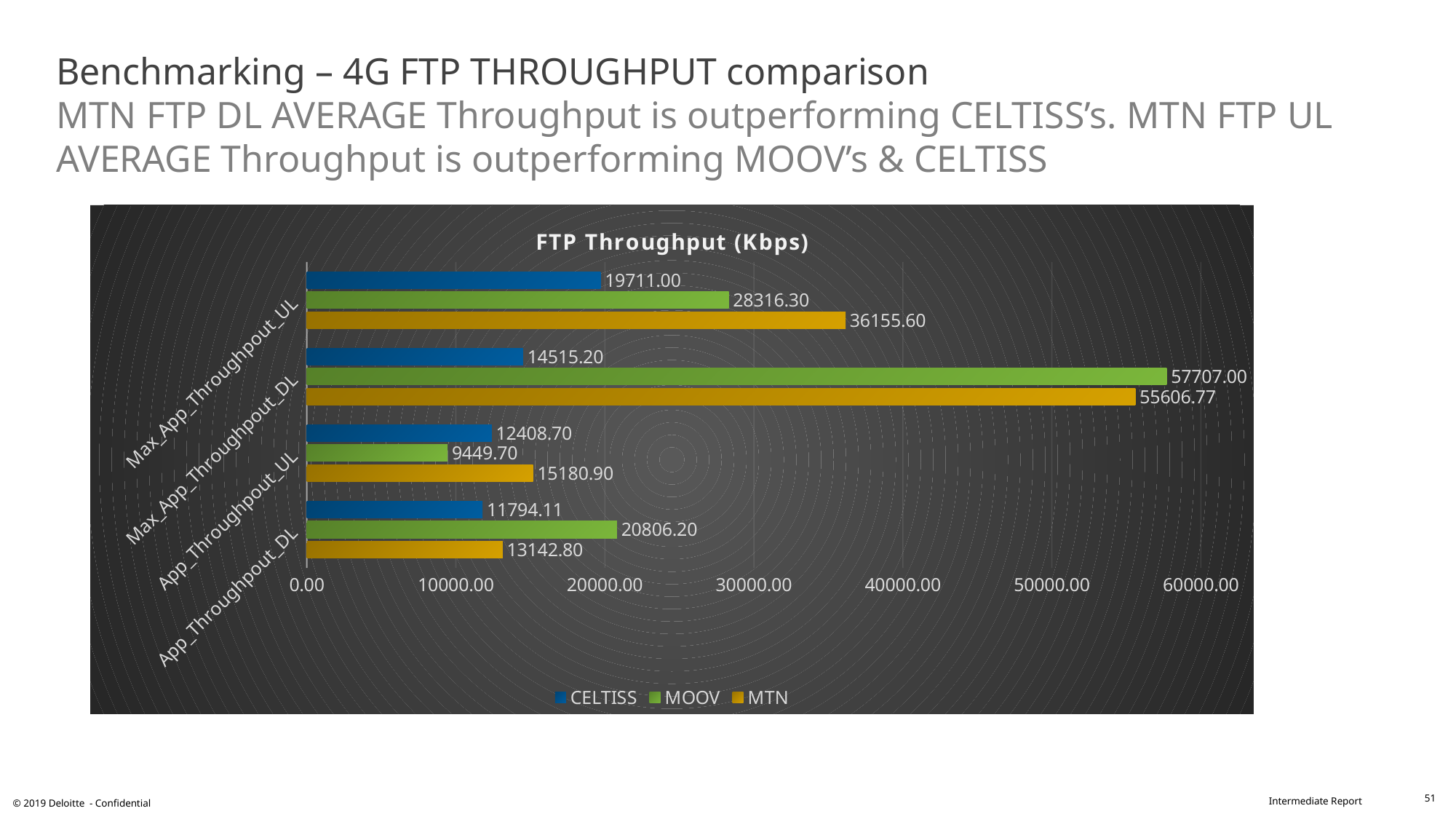
For App_Throughpout_DL, which is larger: the MTN value or the CELTISS value? MTN What is the difference between the MOOV and MTN values for Max_App_Throughpout_DL? 2100.23 How many series does the legend list? 3 What is the difference between the MTN and CELTISS values for Max_App_Throughpout_UL? 16444.60 What is the MTN value for Max_App_Throughpout_UL? 36155.60 What is the CELTISS value for Max_App_Throughpout_DL? 14515.20 Which operator has the highest value for Max_App_Throughpout_DL? MOOV What type of chart is shown on the slide? Bar chart Is the MOOV value for Max_App_Throughpout_UL greater or less than 30000.00? less Which operator has the lowest value for App_Throughpout_UL? MOOV What is the MOOV value for App_Throughpout_DL? 20806.20 How many categories are shown on the chart? 4